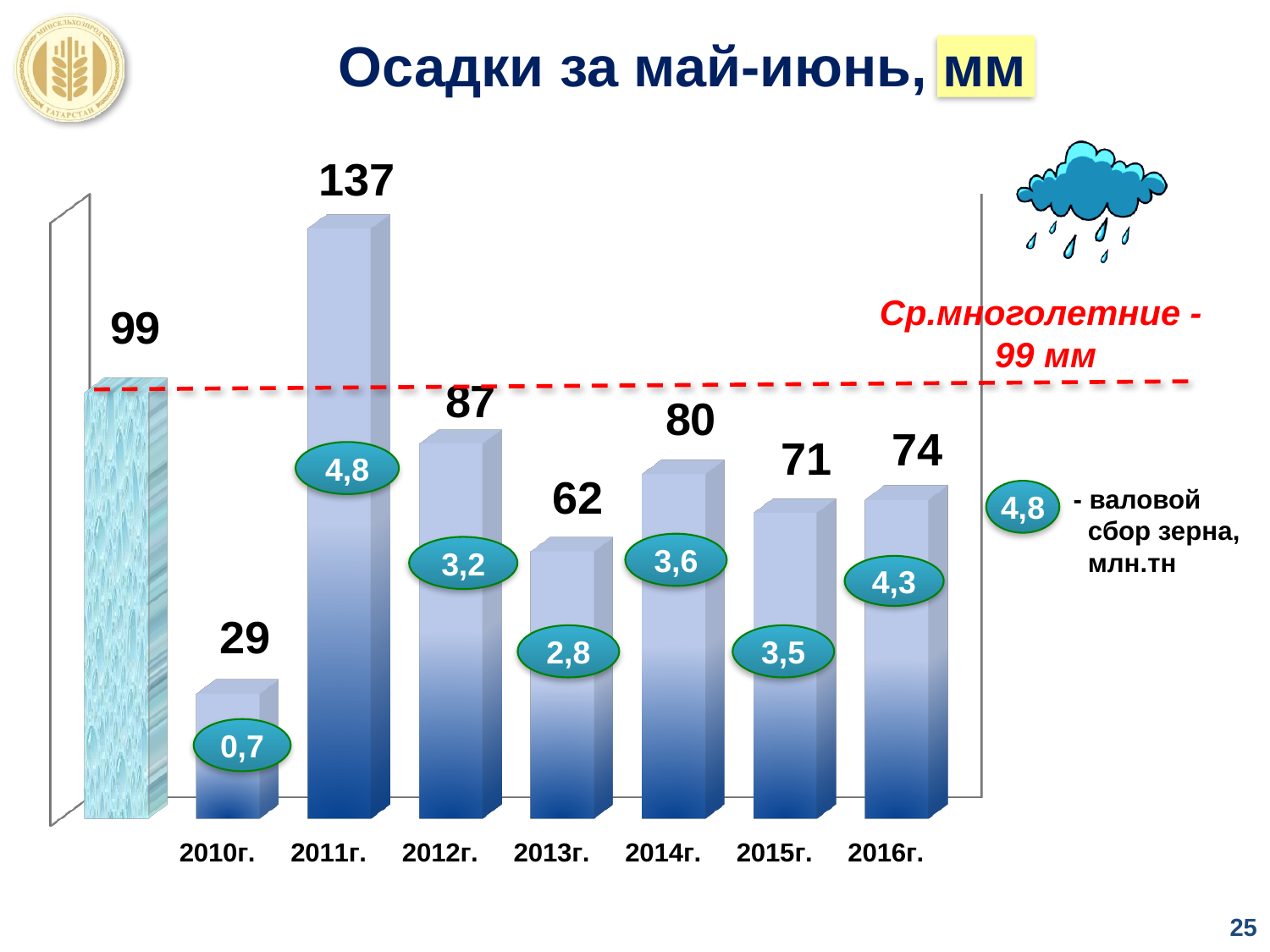
What is the long-term average (Ср.многолетние) precipitation shown by the dashed line, in mm? 99 мм What was the precipitation for May-June in 2016, in mm? 74 What kind of chart is shown on the slide? bar chart Which year had the highest May-June precipitation? 2011г. Which year had the lowest May-June precipitation? 2010г. What is the difference in May-June precipitation between 2011 and 2010, in mm? 108 What was the precipitation for May-June in 2013, in mm? 62 What was the gross grain harvest (валовой сбор зерна) in 2010, in million tonnes? 0,7 Which year had more May-June precipitation, 2012 or 2014? 2012г. How many years are shown on the x axis of the chart? 7 What was the precipitation for May-June in 2011, in mm? 137 What was the gross grain harvest (валовой сбор зерна) in 2016, in million tonnes? 4,3